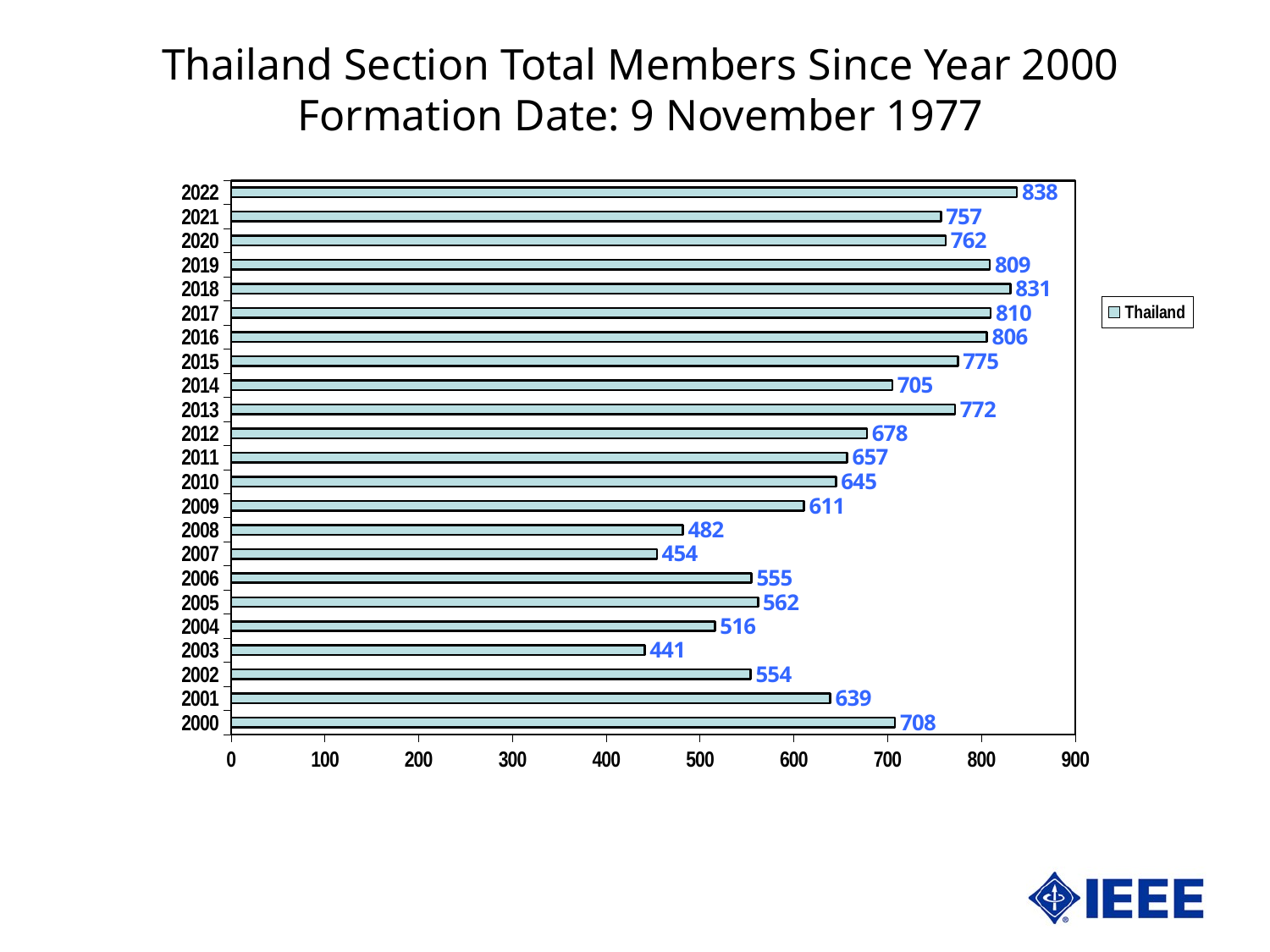
Which year had more members, 2018 or 2019? 2018 How many years are shown in the chart? 23 How many series does the legend list? 1 What type of chart is shown on the slide? Bar chart What was the total number of Thailand Section members in 2003? 441 Which year had more members, 2000 or 2014? 2000 Which year had the lowest number of Thailand Section members? 2003 What is the formation date of the Thailand Section given in the slide title? 9 November 1977 What is the difference in members between 2022 and 2021? 81 What was the total number of Thailand Section members in 2022? 838 What was the total number of Thailand Section members in 2013? 772 Which year had the highest number of Thailand Section members? 2022